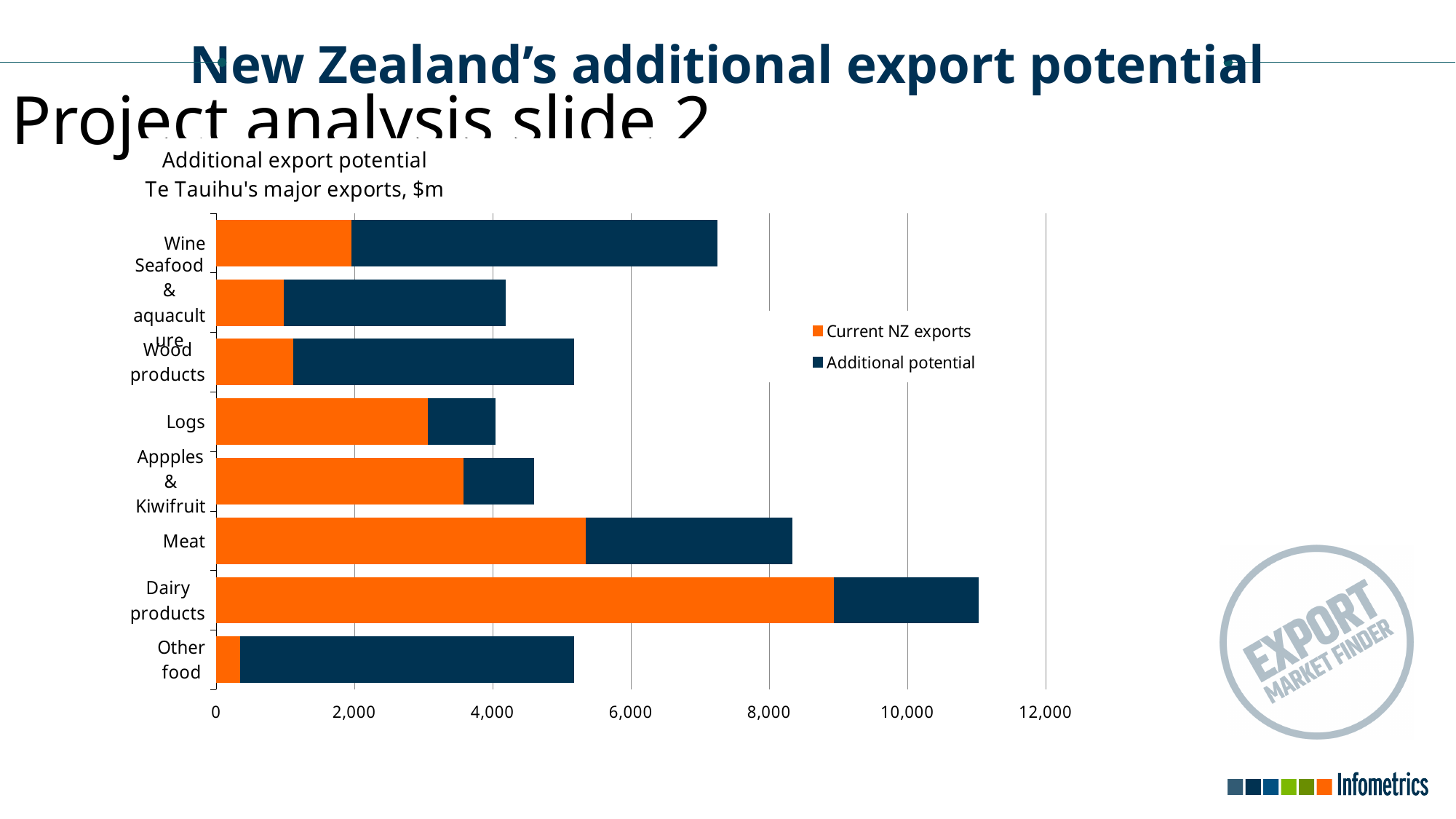
How many series does the legend list? 2 What kind of chart is shown on the slide? Stacked bar chart How many export categories are shown on the chart? 8 Is the Current NZ exports value for Meat greater or less than 4,000? greater Which has the longer total bar, Meat or Wine? Meat Is the total bar for Dairy products greater or less than 10,000? greater Which series is shown in orange in the legend? Current NZ exports Is the Current NZ exports value for Other food greater or less than 2,000? less Which category has the longest total bar (current exports plus additional potential)? Dairy products Which category has the largest Current NZ exports value? Dairy products Which has the larger Current NZ exports value, Logs or Wood products? Logs Which category has the smallest Current NZ exports value? Other food